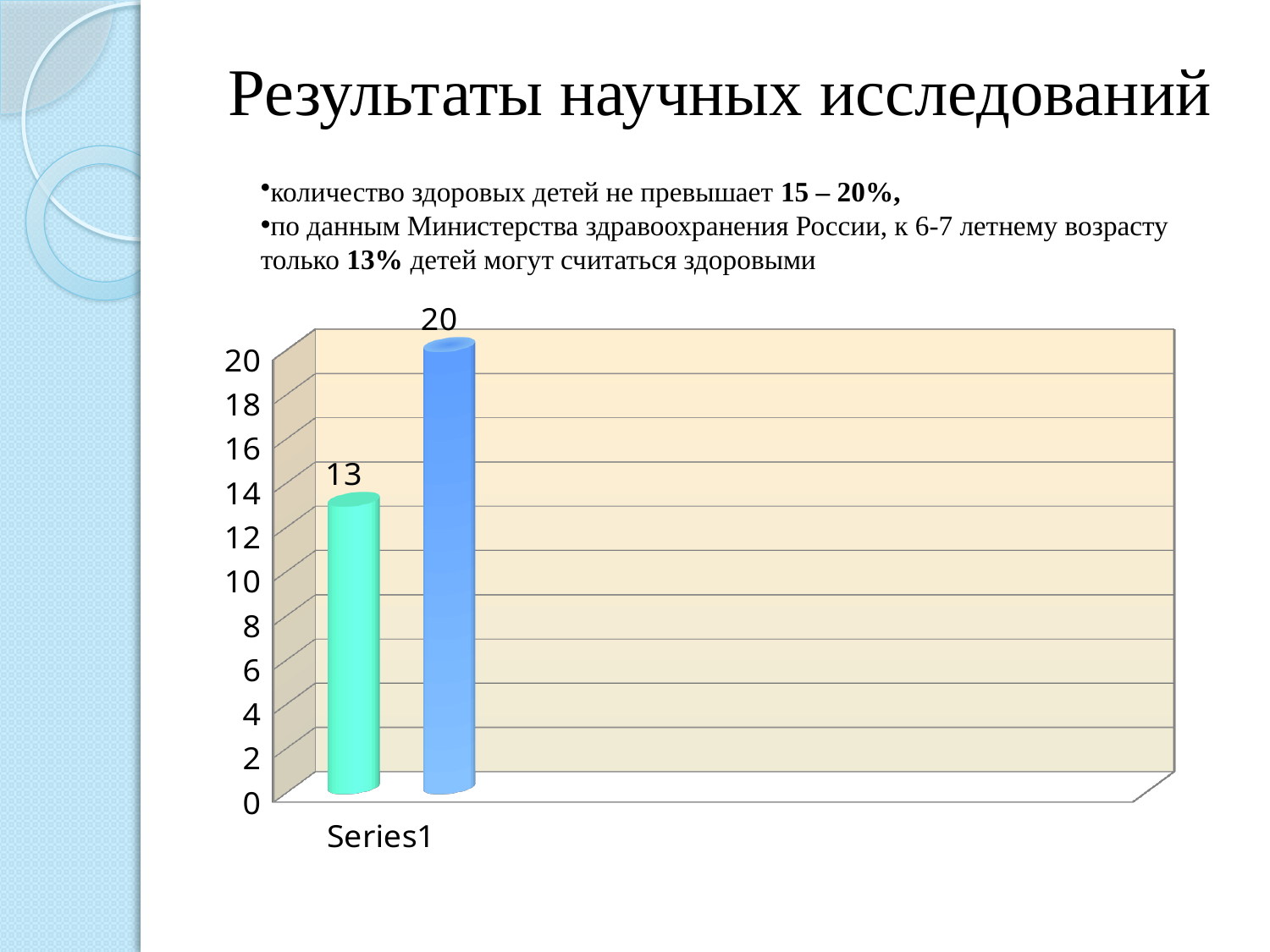
What label appears on the horizontal axis of the chart? Series1 Which bar has the highest value, the green one or the blue one? the blue bar Is the value of the green bar greater or less than 10? greater Which bar has the lowest value, the green one or the blue one? the green bar What value is shown on the blue bar? 20 Is the value of the green bar larger or smaller than the value of the blue bar? smaller What is the highest tick value shown on the vertical axis? 20 What value is shown on the green bar? 13 What kind of chart is shown on the slide? bar chart How many bars are plotted in the chart? 2 What is the difference between the blue bar's value and the green bar's value? 7